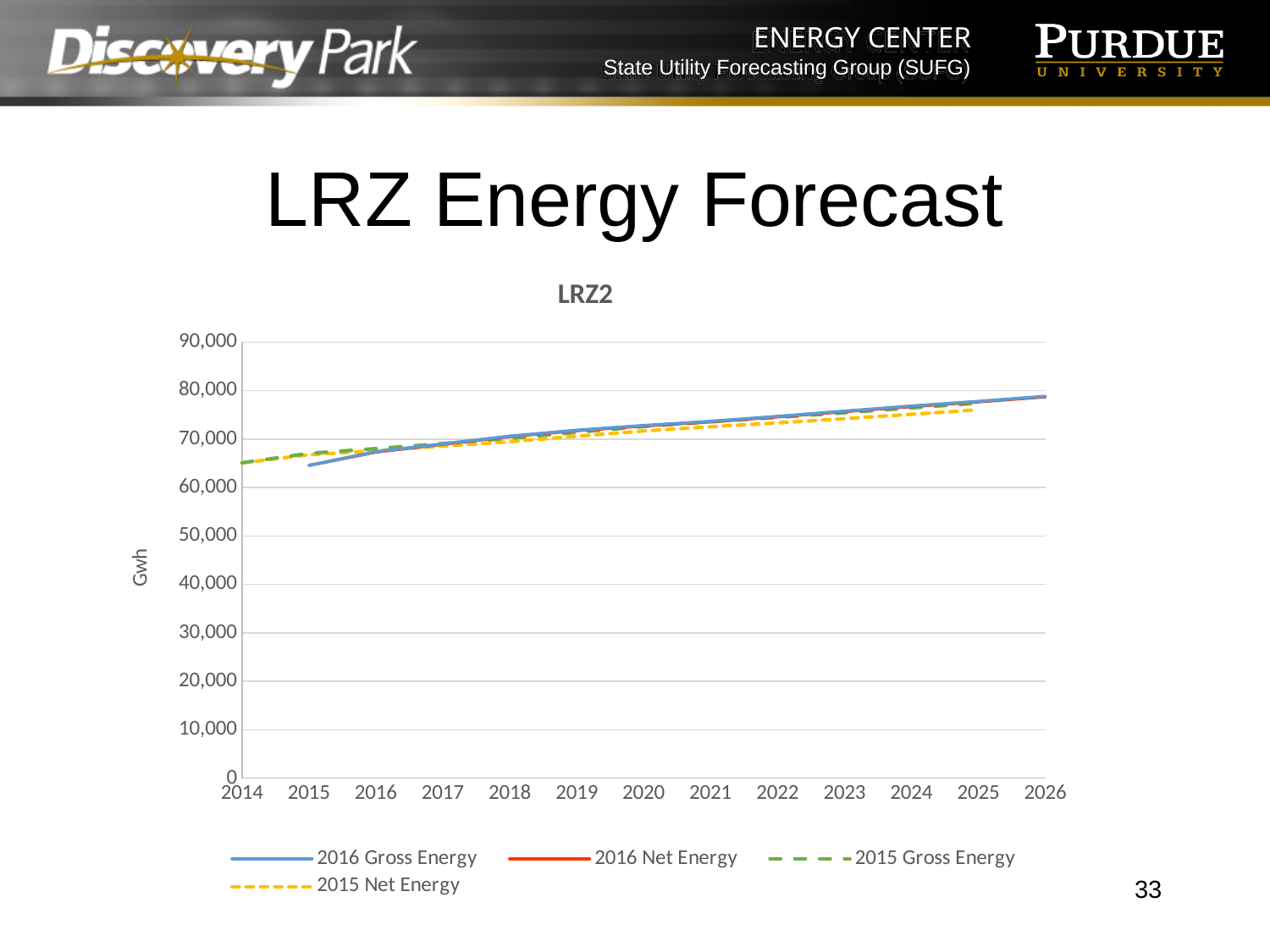
What is the label on the vertical axis? Gwh Is the value for 2016 Gross Energy in 2026 greater or less than 80,000? less Do the values for 2016 Gross Energy rise or fall from 2015 to 2026? Rise In 2015, which is larger: 2015 Gross Energy or 2016 Gross Energy? 2015 Gross Energy Do the values for 2015 Net Energy rise or fall from 2014 to 2025? Rise Is the value for 2016 Gross Energy in 2026 greater or less than 70,000? greater Is the value for 2016 Gross Energy in 2015 greater or less than 70,000? less What kind of chart is shown on the slide? Line chart How many series does the legend list? 4 How many years are labeled on the x axis? 13 What is the title of the chart? LRZ2